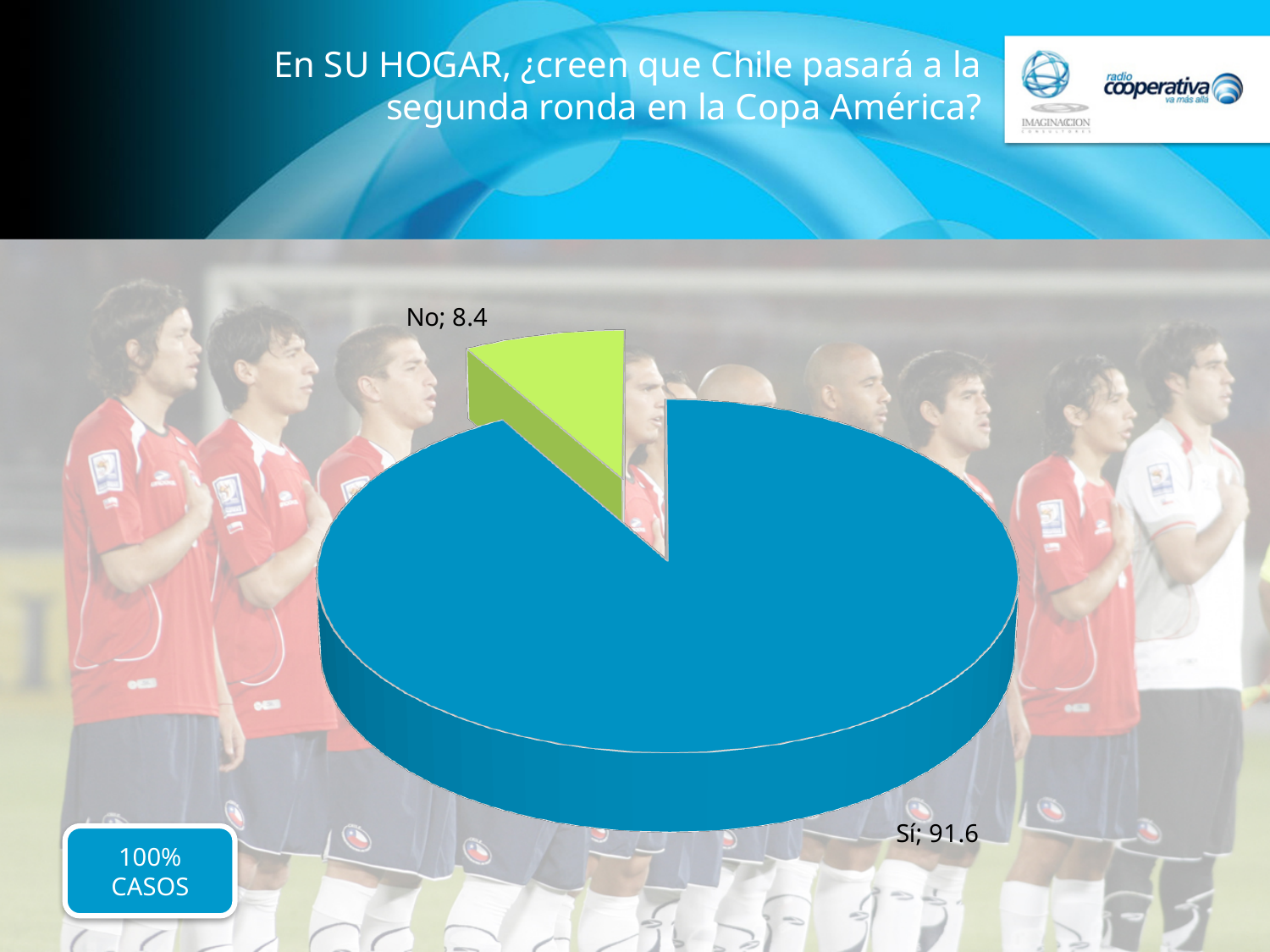
What is the value for "No" in the pie chart? 8.4 What is the difference between the values for "Sí" and "No"? 83.2 How many slices does the pie chart have? 2 What kind of chart is shown on the slide? pie chart Which category has the largest slice in the pie chart? Sí What question does the slide title ask? En SU HOGAR, ¿creen que Chile pasará a la segunda ronda en la Copa América? Which is larger, the value for "Sí" or the value for "No"? Sí What colour is the "No" slice in the pie chart? green What is the total of the two slice values shown in the pie chart? 100 Which category has the smallest slice in the pie chart? No What is the value for "Sí" in the pie chart? 91.6